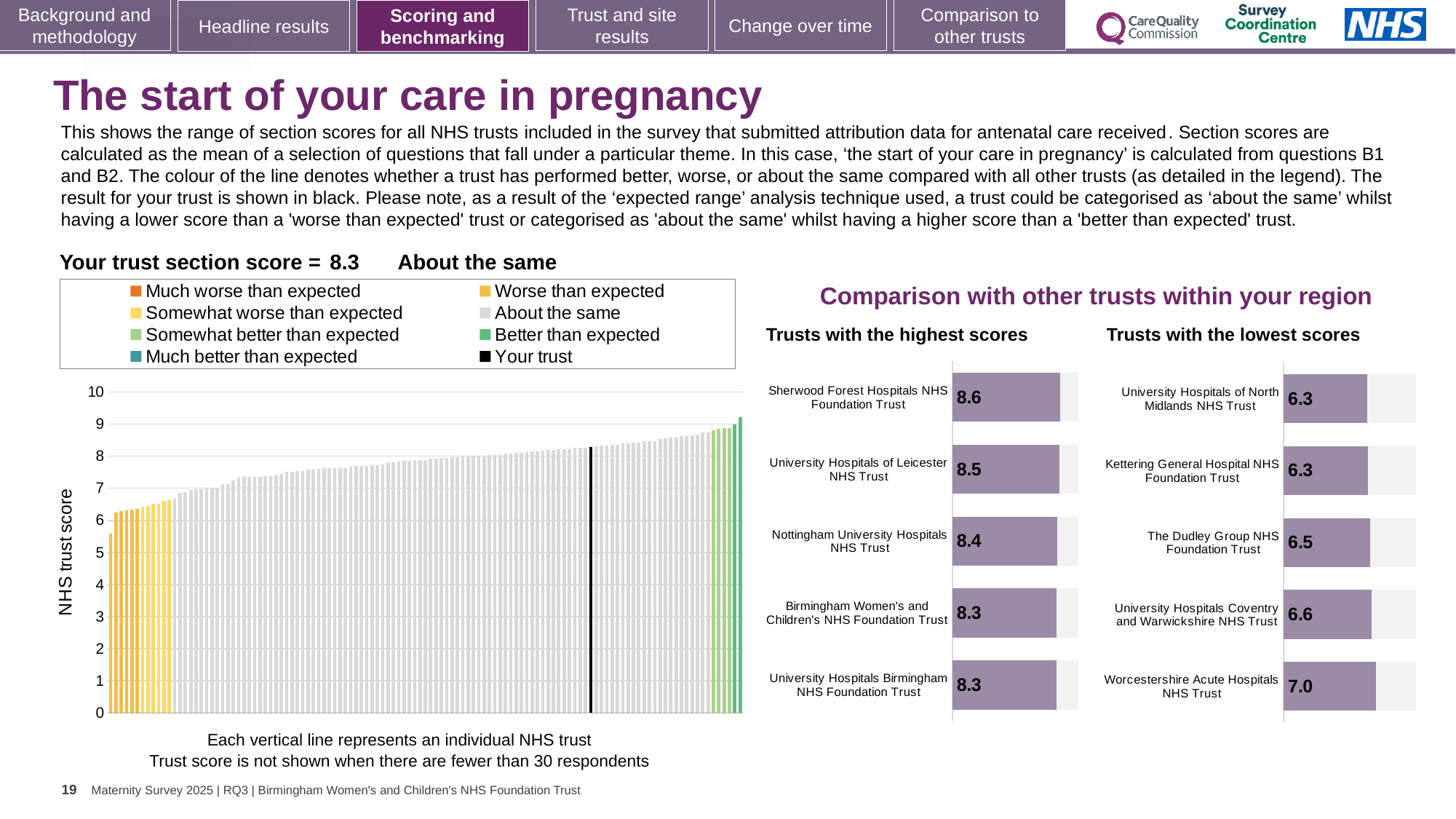
In the 'Trusts with the lowest scores' chart, what is the difference between the scores of Worcestershire Acute Hospitals NHS Trust and University Hospitals of North Midlands NHS Trust? 0.7 In the 'Trusts with the lowest scores' chart, which trust has the highest score? Worcestershire Acute Hospitals NHS Trust In the 'Trusts with the highest scores' chart, what is the difference between the scores of Sherwood Forest Hospitals NHS Foundation Trust and Nottingham University Hospitals NHS Trust? 0.2 What kind of chart is the large 'NHS trust score' chart on the left? Bar chart How many trusts are shown in the 'Trusts with the highest scores' chart? 5 What is your trust's section score shown above the left chart? 8.3 In the large 'NHS trust score' chart on the left, do the bars rise or fall from left to right? Rise In the 'Trusts with the highest scores' chart, which trust has the highest score? Sherwood Forest Hospitals NHS Foundation Trust In the 'Trusts with the highest scores' chart, what is the score for Sherwood Forest Hospitals NHS Foundation Trust? 8.6 In the 'Trusts with the lowest scores' chart, what is the score for Worcestershire Acute Hospitals NHS Trust? 7.0 In the 'Trusts with the lowest scores' chart, which has the larger score: The Dudley Group NHS Foundation Trust or University Hospitals Coventry and Warwickshire NHS Trust? University Hospitals Coventry and Warwickshire NHS Trust How many entries does the legend above the left chart list? 8